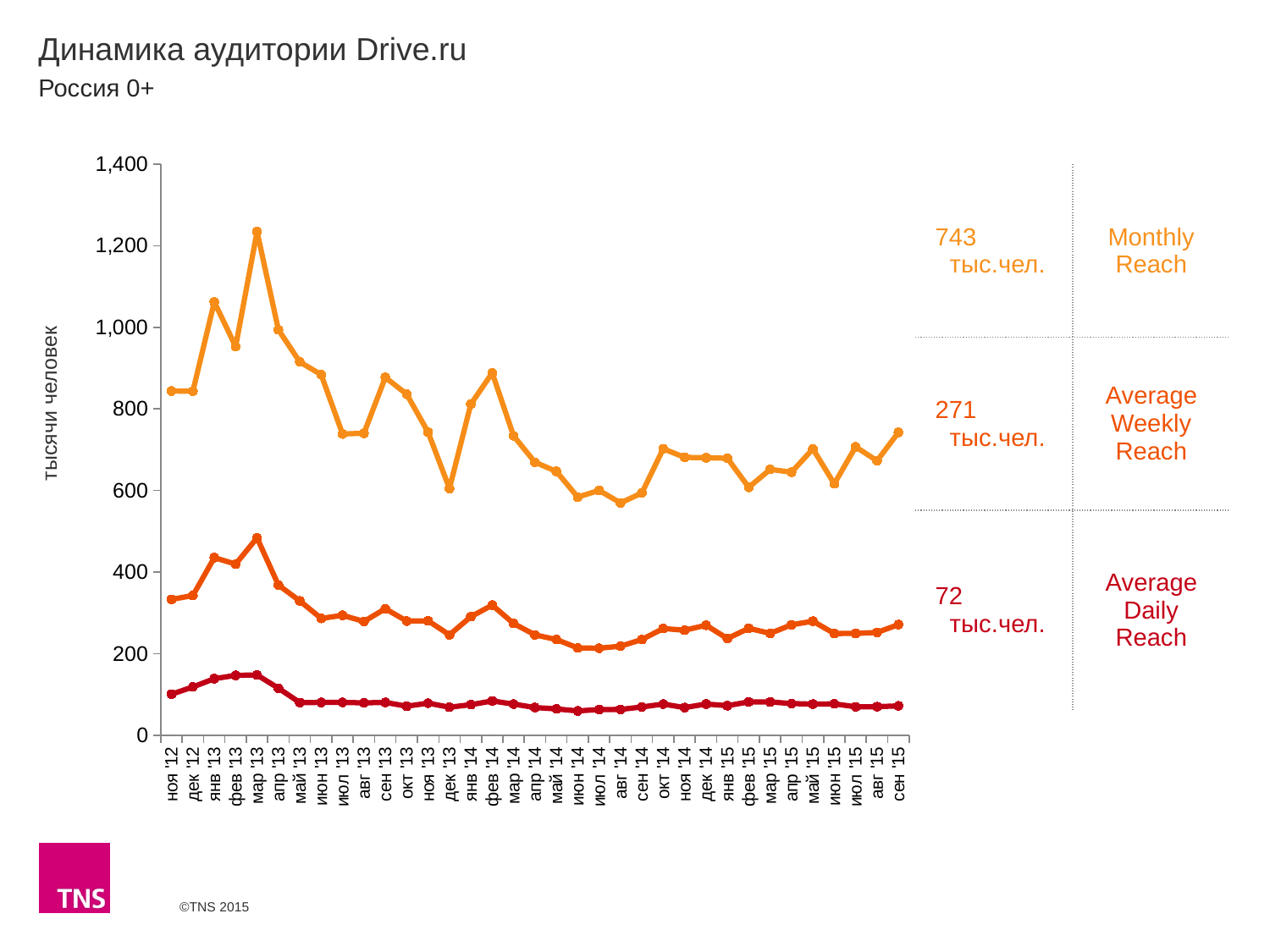
Is the Monthly Reach value for дек '13 greater or less than 800? less Is the Average Weekly Reach value for мар '13 greater or less than 400? greater Is the Monthly Reach value for мар '13 greater or less than 1,200? greater In which month does the Monthly Reach line reach its highest point? мар '13 What is the label of the vertical axis? тысячи человек What type of chart is shown on the slide? line chart What Monthly Reach value is printed on the right side of the slide? 743 тыс.чел. How many data series (lines) are plotted on the chart? 3 Does the Monthly Reach line rise or fall between мар '13 and дек '13? fall What Average Daily Reach value is printed on the right side of the slide? 72 тыс.чел. Which month has the higher Monthly Reach, янв '13 or фев '13? янв '13